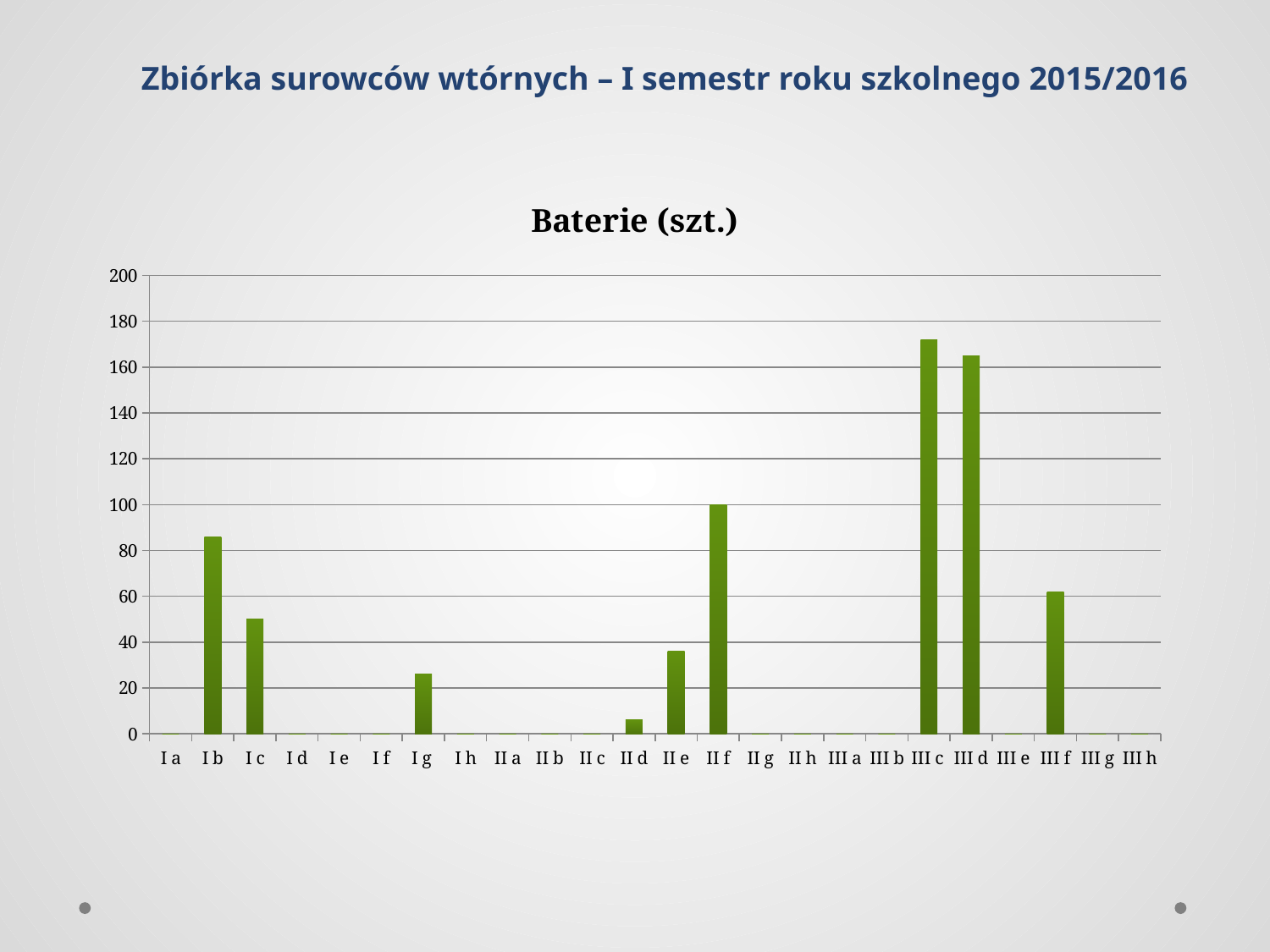
What kind of chart is shown on the slide? bar chart Which is larger, the value for II f or the value for III f? II f What is the title of the chart? Baterie (szt.) What is the value for II f? 100 Which category has the highest value? III c Is the value for II e greater or less than 20? greater Which is larger, the value for I b or the value for I c? I b Is the value for III d greater or less than 180? less Is the value for III c greater or less than 160? greater How many categories are shown on the x axis of the chart? 24